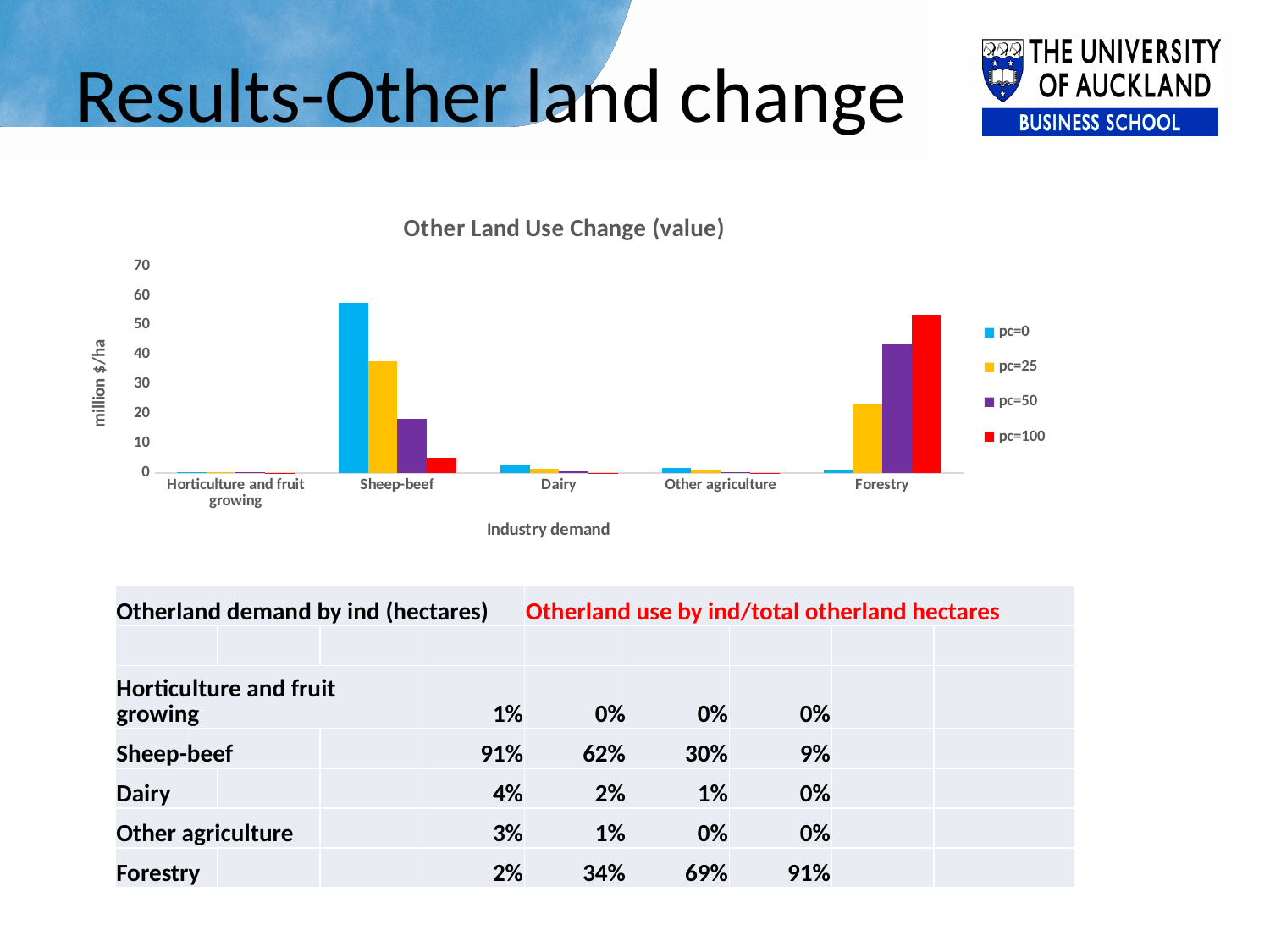
Which industry has the highest value for the pc=50 series? Forestry Which industry has the highest value for the pc=100 series? Forestry What is the title of the chart? Other Land Use Change (value) Which industry has the highest value for the pc=0 series? Sheep-beef How many industry categories are shown on the x axis of the chart? 5 What kind of chart is shown on the slide? bar chart For Forestry, which series has the larger value: pc=25 or pc=50? pc=50 For Sheep-beef, which series has the larger value: pc=0 or pc=25? pc=0 Is the pc=0 value for Sheep-beef greater or less than 50? greater Is the pc=100 value for Sheep-beef greater or less than 10? less How many series does the chart's legend list? 4 Is the pc=25 value for Forestry greater or less than 30? less